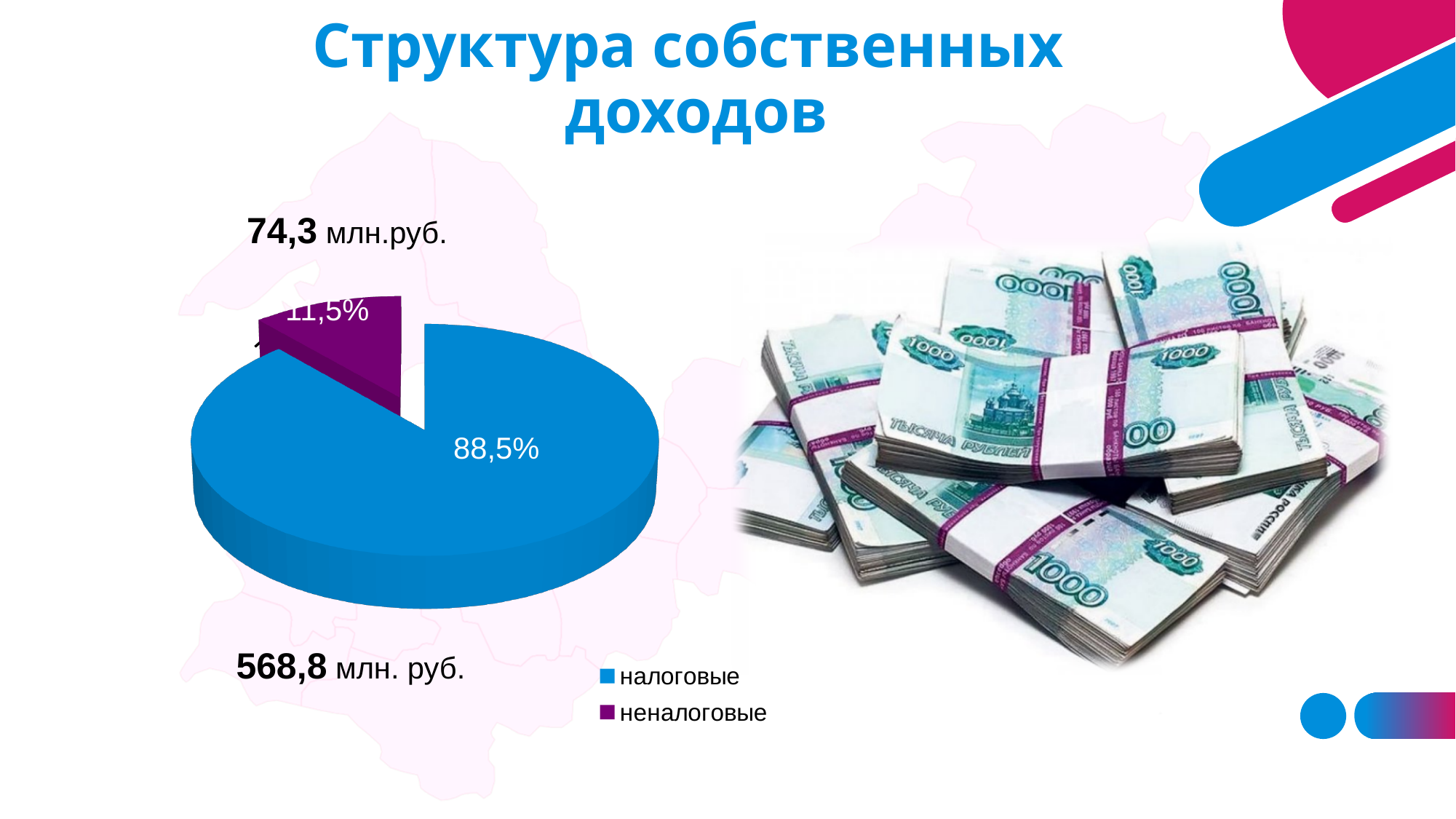
Which slice is larger, налоговые or неналоговые? налоговые What amount in млн. руб. is printed next to the налоговые slice? 568,8 What colour is the налоговые slice in the pie chart? blue What type of chart is shown on the slide? pie chart By how many percentage points does the налоговые share exceed the неналоговые share? 77% How many slices does the pie chart have? 2 Which category has the smallest slice of the pie? неналоговые What share of the pie does the налоговые slice have? 88,5% Which category has the largest slice of the pie? налоговые What is the title of the slide with the pie chart? Структура собственных доходов What share of the pie does the неналоговые slice have? 11,5% How many entries does the legend list? 2